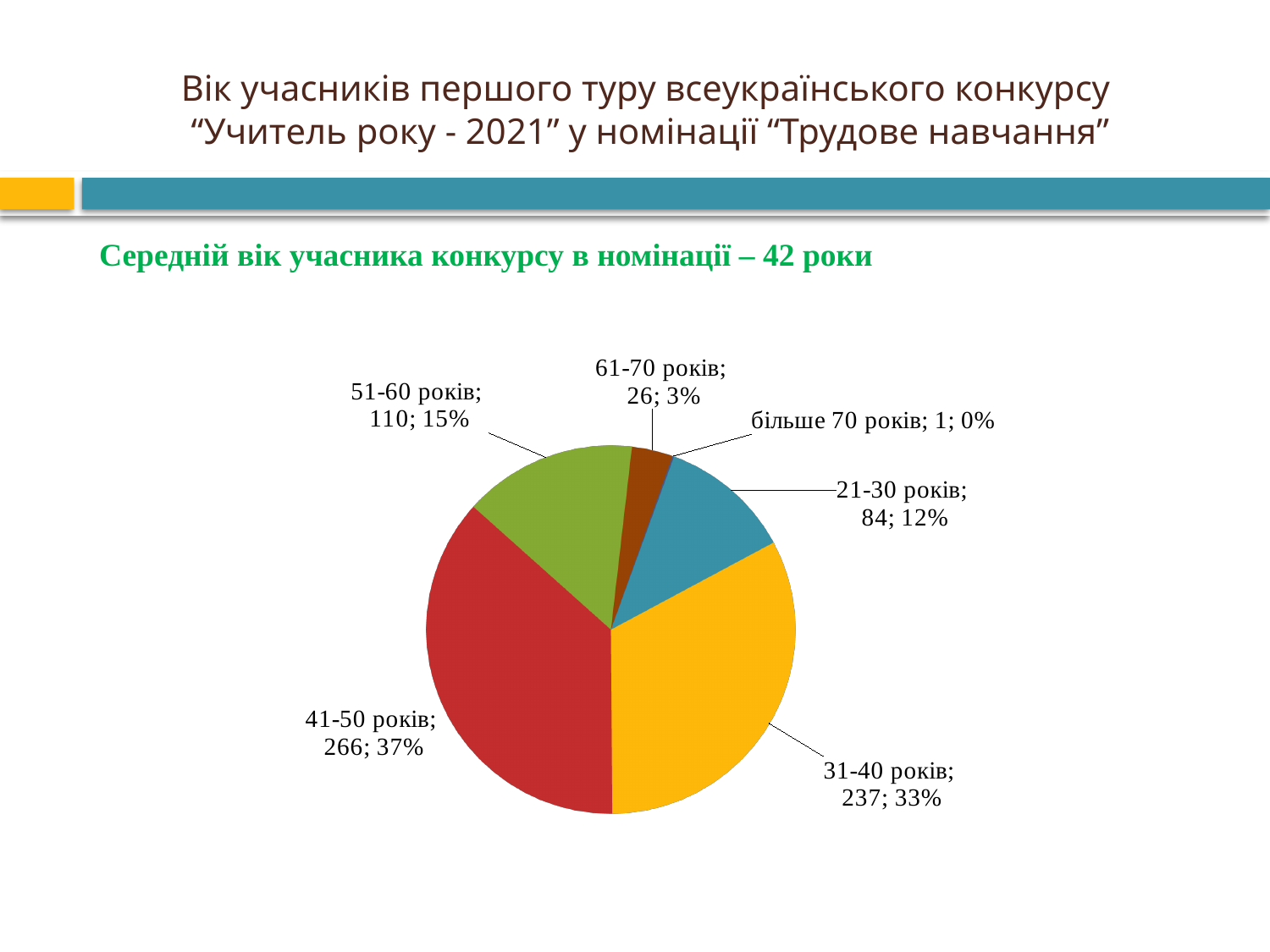
What is the value for the 21-30 років category? 84 What kind of chart is shown on the slide? pie chart Which age category has the largest slice? 41-50 років What is the number of participants in the 41-50 років category? 266 What is the difference between the values for 41-50 років and 31-40 років? 29 What percentage share does the 61-70 років slice have? 3% What is the value for the 51-60 років category? 110 Which is larger, the value for 51-60 років or the value for 21-30 років? 51-60 років How many age categories does the pie chart show? 6 What percentage share does the 31-40 років slice have? 33% What average age of a participant is stated on the slide? 42 роки Which age category has the smallest slice? більше 70 років